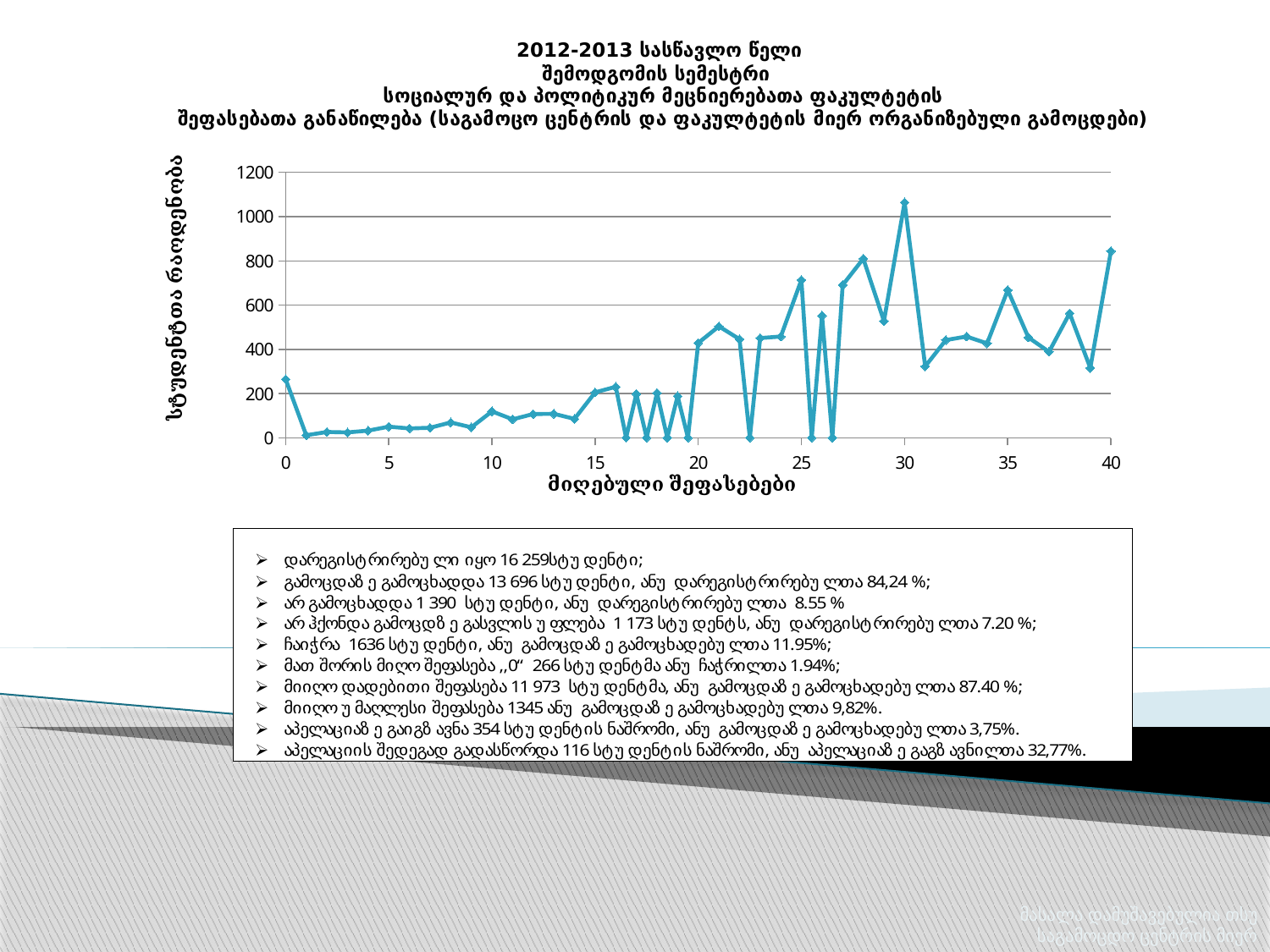
Which is larger, the value at x = 28 or the value at x = 31? x = 28 Is the value at x = 40 greater or less than 600? greater Which is larger, the value at x = 30 or the value at x = 40? x = 30 What is the title of the vertical axis? სტუდენტთა რაოდენობა Is the value at x = 30 greater or less than 1000? greater Is the value at x = 25 greater or less than 600? greater At which value on the x axis (მიღებული შეფასებები) does the line reach its highest point? 30 What is the title of the horizontal axis? მიღებული შეფასებები What kind of chart is shown on the slide? line chart Overall, do the values rise or fall as the x axis goes from 0 to 40? rise